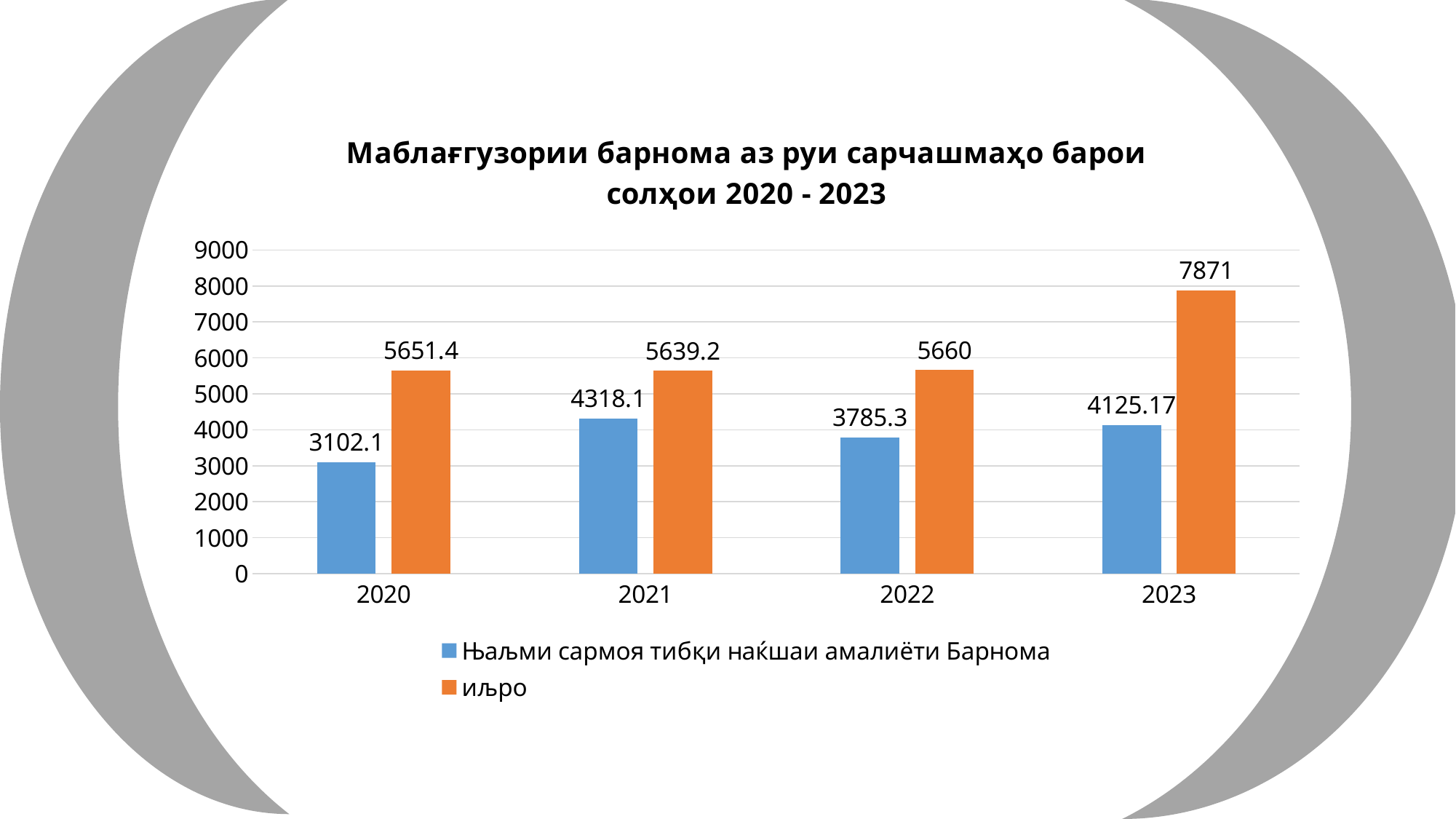
In which year is the blue bar lowest? 2020 What is the value of the blue bar for 2023? 4125.17 Is the blue bar for 2021 greater or less than 4000? greater Which is larger for 2021: the blue bar or the orange "иљро" bar? The orange "иљро" bar What kind of chart is shown on the slide? Bar chart What is the value of the orange "иљро" bar for 2023? 7871 What is the value of the orange "иљро" bar for 2021? 5639.2 What is the value of the blue bar for 2020? 3102.1 How many years are shown on the x axis? 4 In which year is the orange "иљро" bar highest? 2023 What is the difference between the orange and blue bars for 2022? 1874.7 How many series does the legend list? 2